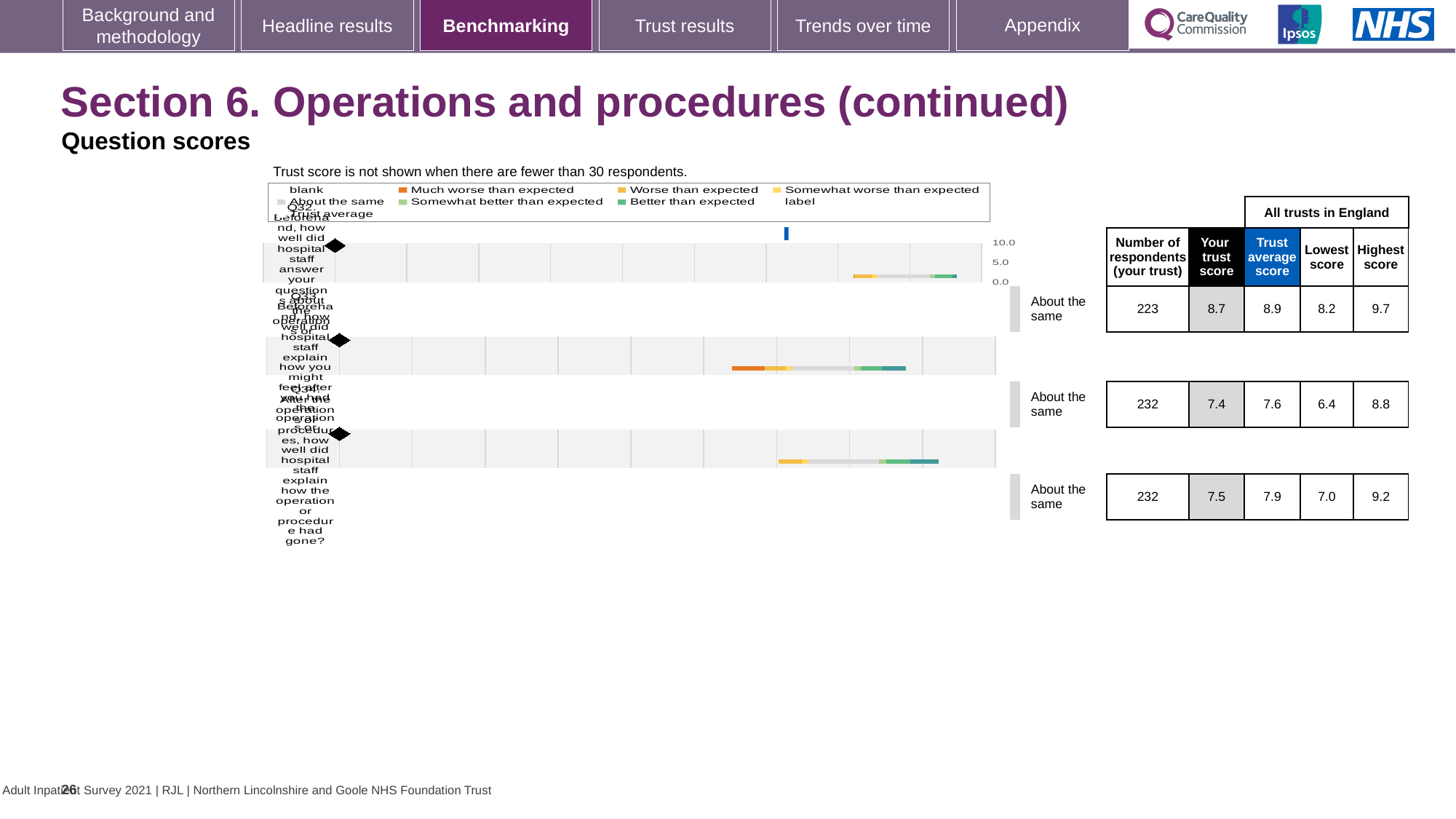
What kind of chart is used to show the question scores on this slide? bar chart In the table beside the chart, what is the number of respondents for the first question row? 223 What is the 'Trust average score' for the second question row? 7.6 What is the 'Highest score' for the third question row? 9.2 What is 'Your trust score' for the first question row? 8.7 How many questions (rows) are plotted in the benchmarking chart? 3 Which question row has the highest 'Your trust score'? The first row (8.7) What is the 'Lowest score' for the first question row? 8.2 Which question row has the lowest 'Lowest score' value? The second row (6.4) For the second question row, which is larger: your trust score or the trust average score? Trust average score What benchmark category is shown next to each of the three questions? About the same For the first question row, what is the difference between the trust average score (8.9) and your trust score (8.7)? 0.2